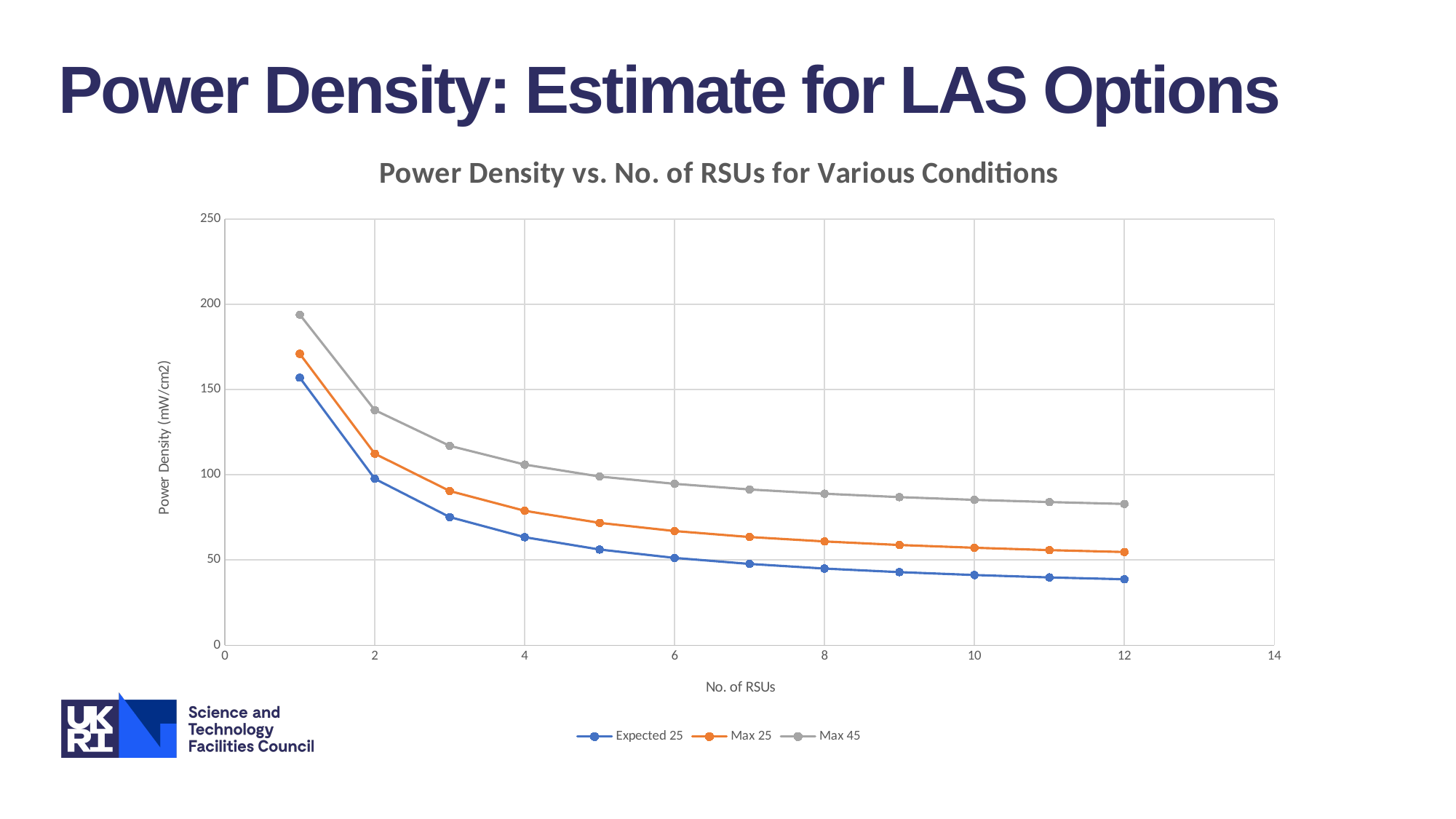
How many series does the legend list? 3 Is the value for Max 45 at 1 RSU greater or less than 150? greater Is the value for Max 25 at 2 RSUs greater or less than 100? greater What kind of chart is shown on the slide? line chart At 6 RSUs, which is larger: the value for Max 45 or the value for Expected 25? Max 45 Which series has the lowest power density at 12 RSUs? Expected 25 How many data points are plotted for the Expected 25 series? 12 Is the value for Expected 25 at 12 RSUs greater or less than 50? less Which series has the highest power density at 1 RSU? Max 45 What is the title of the chart? Power Density vs. No. of RSUs for Various Conditions Do the values for Max 45 rise or fall as the number of RSUs increases? fall